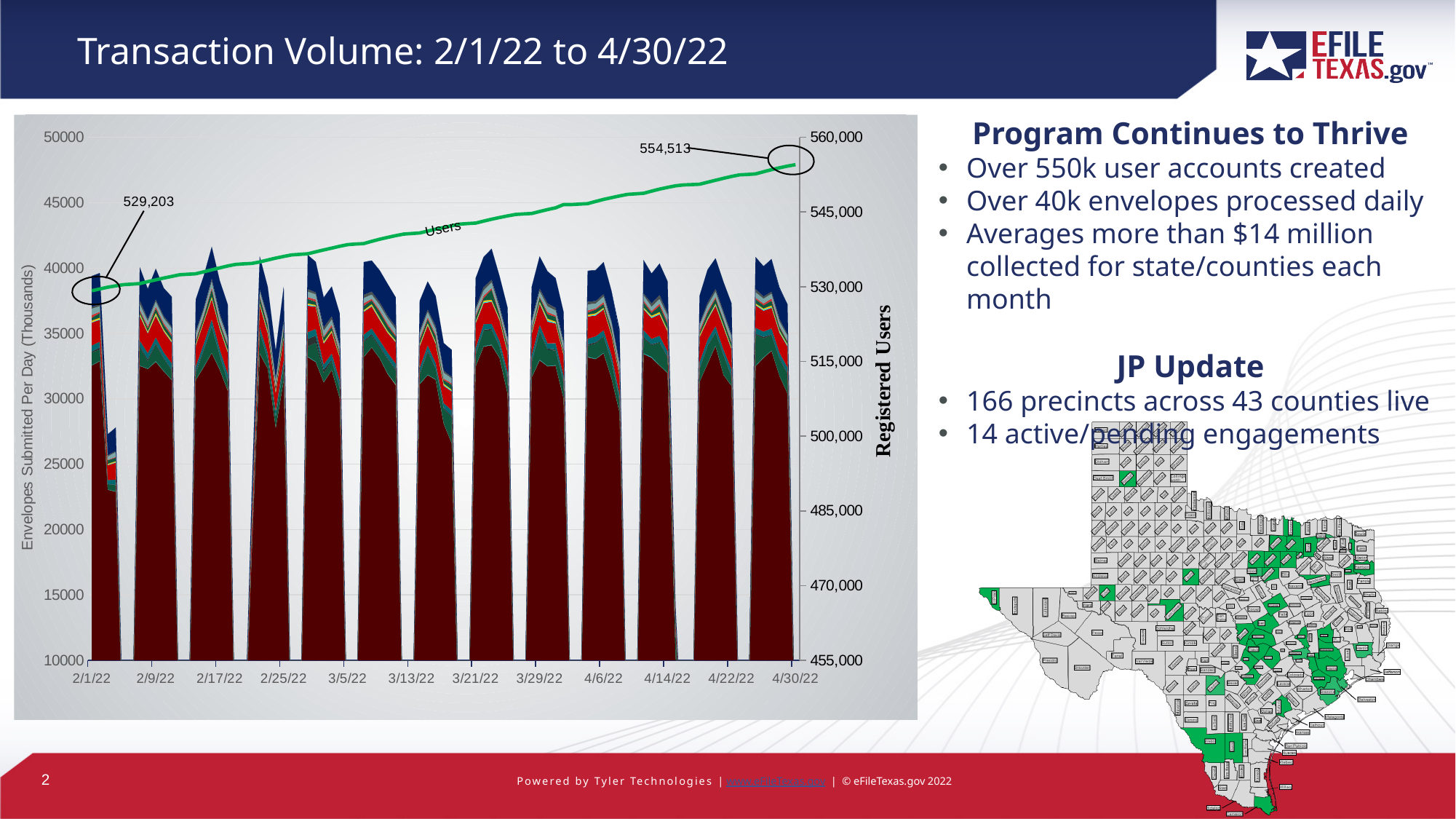
What is the highest tick value shown on the right-hand axis of the chart? 560,000 By how much did the labelled registered users value increase from 2/1/22 to 4/30/22? 25,310 Is the Users line value on 4/30/22 greater or less than 545,000? greater Is the Users line value on 2/1/22 greater or less than 545,000? less What is the title of the right-hand vertical axis of the chart? Registered Users What is the registered users value labelled at the start of the chart on 2/1/22? 529,203 Which date has the larger labelled registered users value, 2/1/22 or 4/30/22? 4/30/22 How many date labels are shown along the x axis of the chart? 12 What is the registered users value labelled at the end of the chart on 4/30/22? 554,513 Does the Users line rise or fall from 2/1/22 to 4/30/22? rises What is the label of the line series plotted on the chart? Users What is the lowest tick value shown on the left-hand axis of the chart? 10000